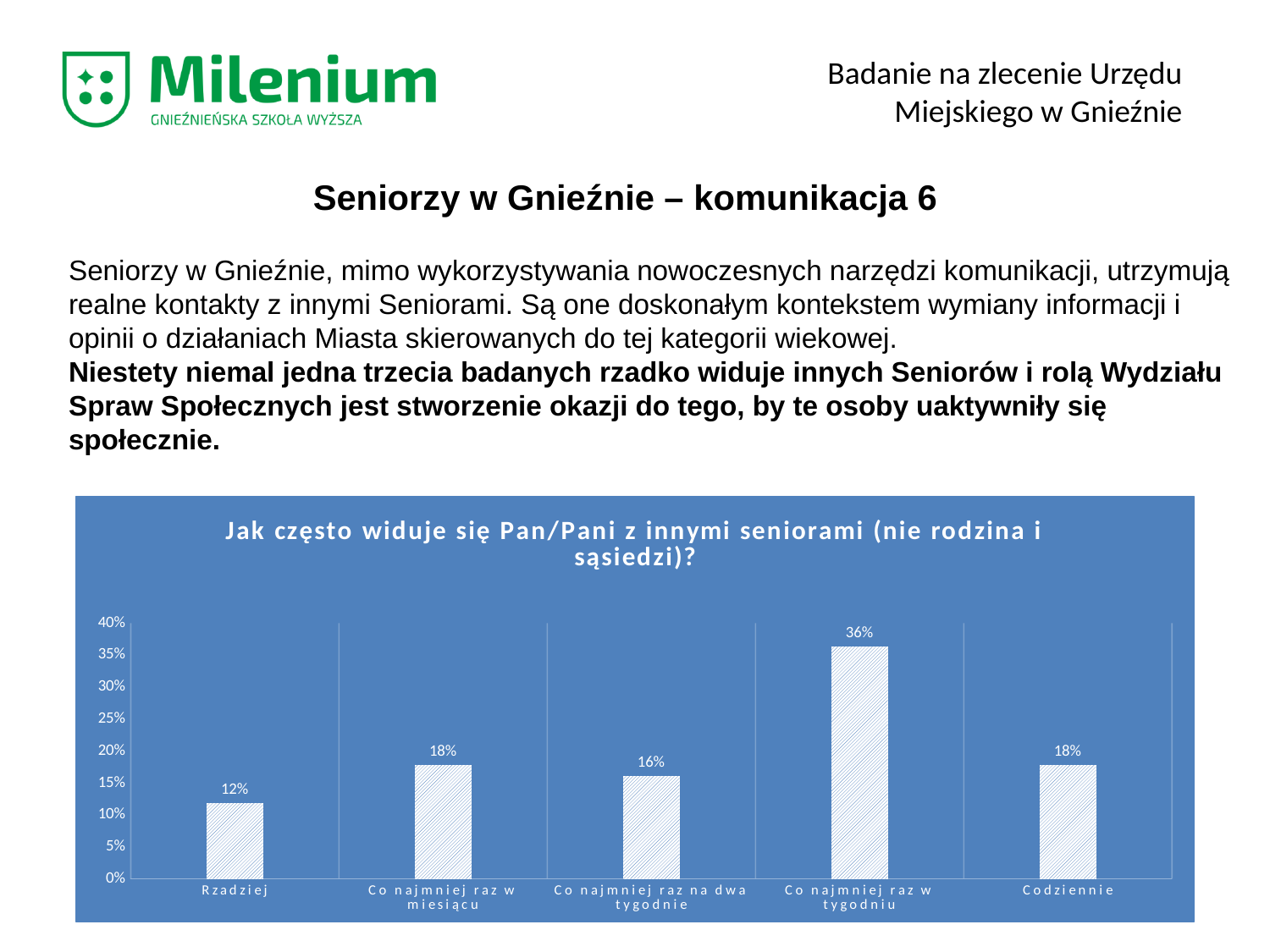
Which category has the lowest value? Rzadziej What kind of chart is shown on the slide? bar chart Which category has the highest value? Co najmniej raz w tygodniu What is the value for "Rzadziej"? 12% What is the value for "Codziennie"? 18% Is the value for "Co najmniej raz w tygodniu" greater or less than 30%? greater What is the value for "Co najmniej raz na dwa tygodnie"? 16% What is the difference between the values for "Co najmniej raz w tygodniu" and "Rzadziej"? 24% What is the value for "Co najmniej raz w tygodniu"? 36% How many categories are shown on the x axis? 5 Which is larger, the value for "Co najmniej raz w miesiącu" or the value for "Co najmniej raz na dwa tygodnie"? Co najmniej raz w miesiącu What is the title of the chart? Jak często widuje się Pan/Pani z innymi seniorami (nie rodzina i sąsiedzi)?